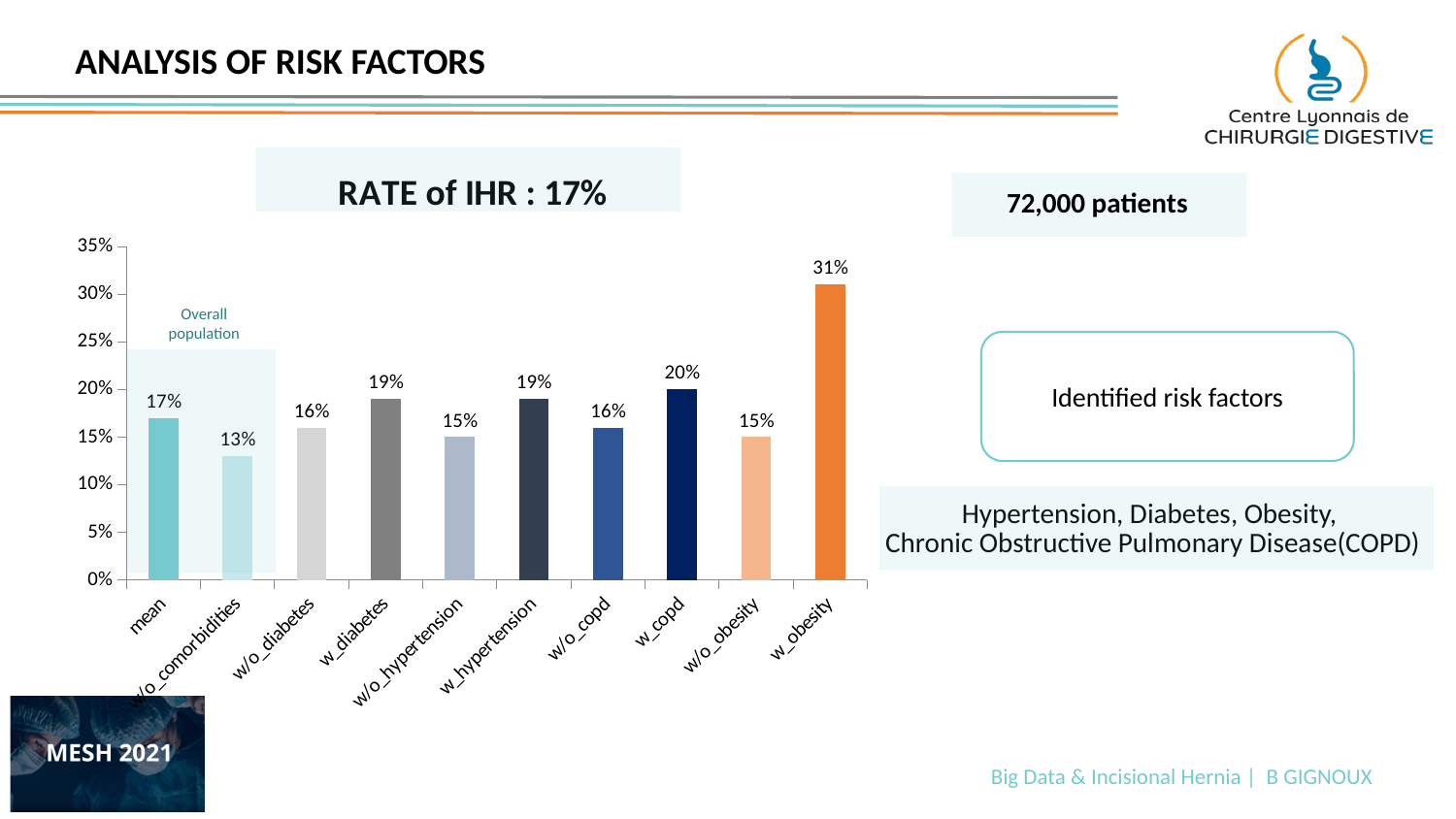
What is the value for w/o_comorbidities? 13% What is the value for w_obesity? 31% Is the value for w_obesity greater or less than 25%? greater What kind of chart is shown on the slide? bar chart What is the value for w_copd? 20% Which is larger, the value for w_diabetes or the value for w/o_diabetes? w_diabetes Which category has the highest value? w_obesity What is the value for the mean category? 17% How many categories are shown on the x axis? 10 Which category has the lowest value? w/o_comorbidities What is the difference between the values for w_hypertension and w/o_hypertension? 4% What is the difference between the values for w_obesity and w/o_obesity? 16%